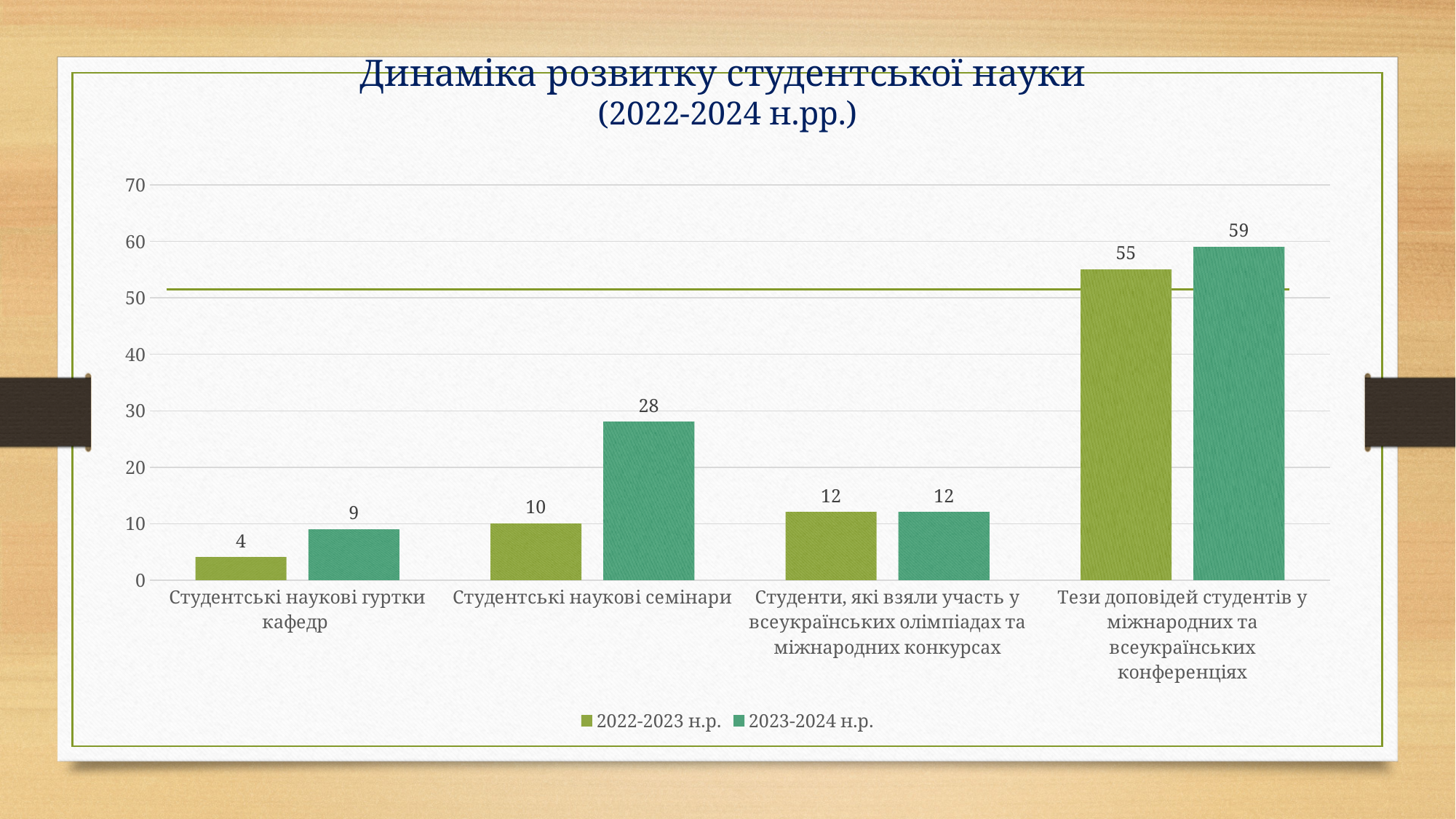
What is the value for 'Тези доповідей студентів у міжнародних та всеукраїнських конференціях' in the 2022-2023 н.р. series? 55 What kind of chart is shown on the slide? bar chart Is the 2023-2024 н.р. value for 'Тези доповідей студентів у міжнародних та всеукраїнських конференціях' greater or less than 50? greater What is the value for 'Студентські наукові гуртки кафедр' in the 2022-2023 н.р. series? 4 Which is larger for 'Студентські наукові гуртки кафедр': the 2022-2023 н.р. value or the 2023-2024 н.р. value? 2023-2024 н.р. What is the difference between the 2023-2024 н.р. and 2022-2023 н.р. values for 'Студентські наукові семінари'? 18 Which category has the highest value in the 2023-2024 н.р. series? Тези доповідей студентів у міжнародних та всеукраїнських конференціях What is the value for 'Студентські наукові семінари' in the 2023-2024 н.р. series? 28 What is the title of the chart? Динаміка розвитку студентської науки (2022-2024 н.рр.) How many categories are shown on the x axis? 4 Which category has the lowest value in the 2022-2023 н.р. series? Студентські наукові гуртки кафедр How many series does the legend list? 2